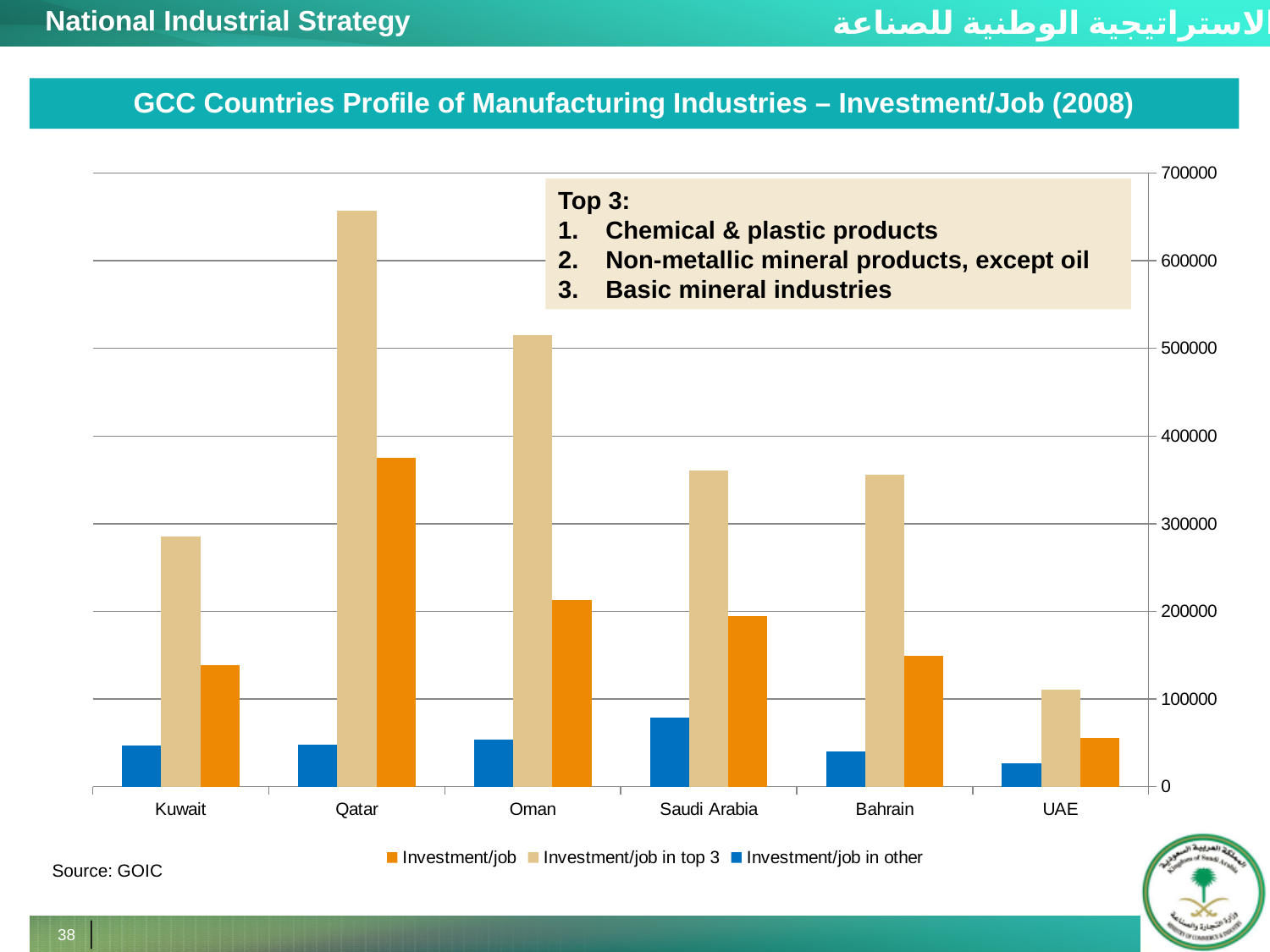
What kind of chart is shown on the slide? Bar chart Which series in the legend is shown in blue? Investment/job in other Which country has the lowest value for Investment/job in top 3? UAE Which country has the highest value for Investment/job in other? Saudi Arabia Is the value for Investment/job for Qatar greater or less than 400000? less Is the value for Investment/job in top 3 for Qatar greater or less than 600000? greater Which is larger, the Investment/job in top 3 value for Oman or for Saudi Arabia? Oman How many countries are shown on the x axis of the chart? 6 Which country has the highest value for Investment/job in top 3? Qatar Is the value for Investment/job in top 3 for Kuwait greater or less than 300000? less Which country has the lowest value for Investment/job? UAE How many series does the chart's legend list? 3